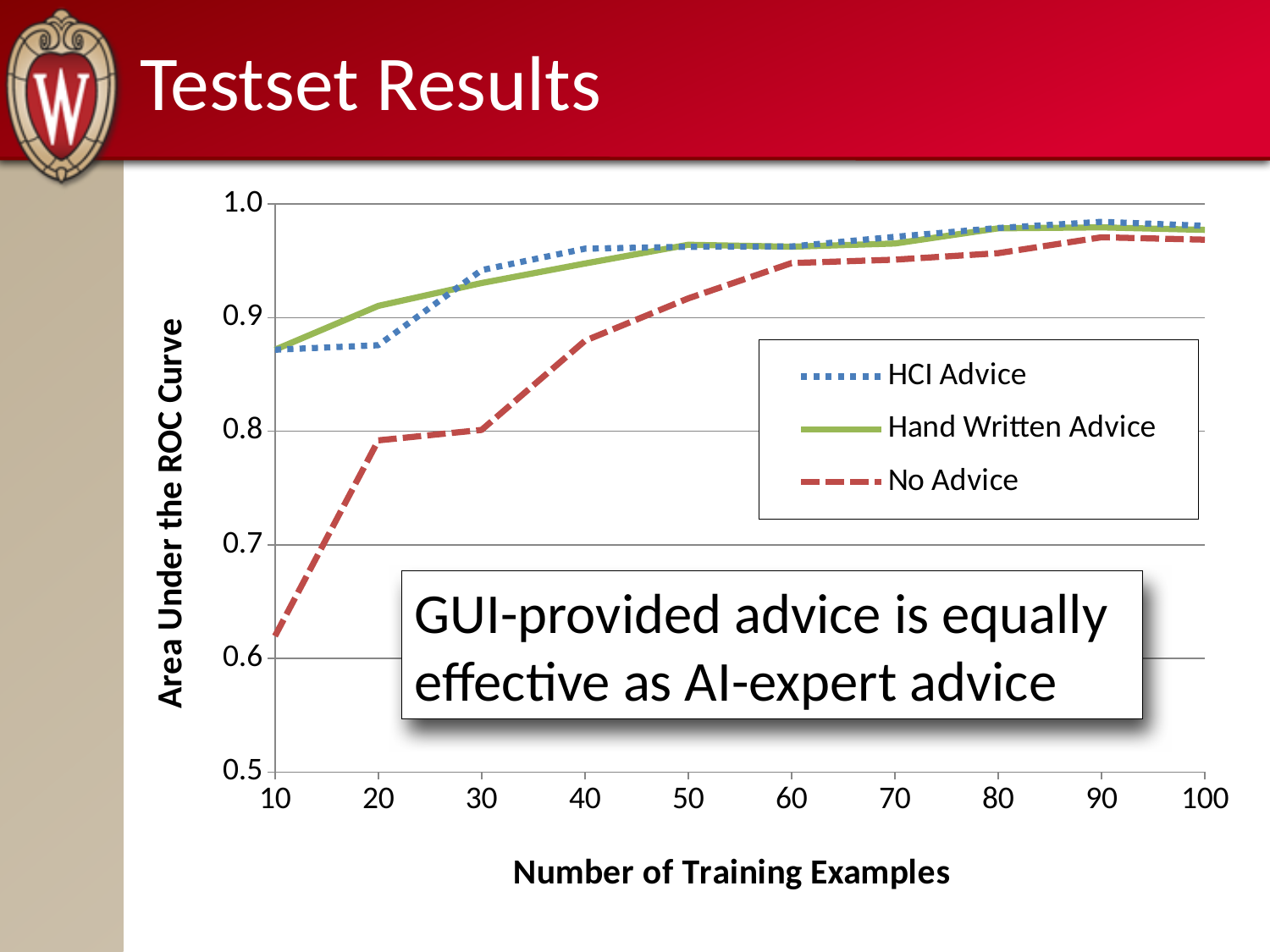
What is the title of the y axis? Area Under the ROC Curve At 30 training examples, which is larger: HCI Advice or No Advice? HCI Advice Which series has the lowest value at 10 training examples? No Advice Is the value for HCI Advice at 10 training examples greater or less than 0.9? less What is the title of the x axis? Number of Training Examples What kind of chart is shown on the slide? line chart How many series does the legend list? 3 Is the value for No Advice at 40 training examples greater or less than 0.9? less At 20 training examples, which is larger: Hand Written Advice or HCI Advice? Hand Written Advice Does the No Advice series rise or fall as the number of training examples increases? rise Is the value for No Advice at 10 training examples greater or less than 0.7? less